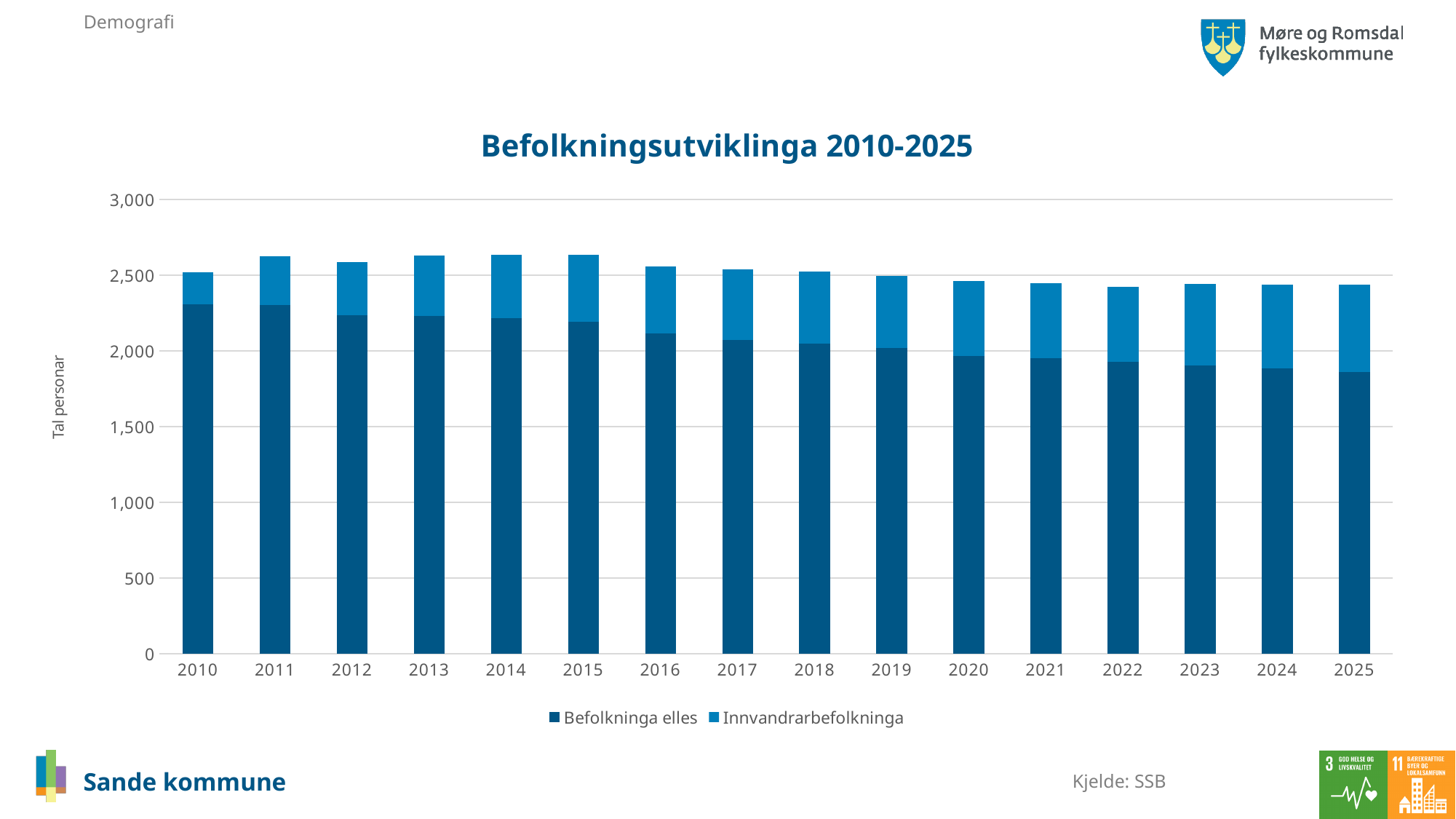
What is the label on the y axis of the chart? Tal personar Is the value of Befolkninga elles for 2025 greater or less than 2,000? less Does the Befolkninga elles series rise or fall from 2010 to 2025? fall Is the value of Befolkninga elles for 2010 greater or less than 2,000? greater Which year has the larger value for Befolkninga elles, 2010 or 2025? 2010 Which year has the taller stacked bar in total, 2013 or 2022? 2013 How many years are shown on the x axis of the chart? 16 Is the total height of the stacked bar for 2022 greater or less than 2,500? less What is the title of the chart? Befolkningsutviklinga 2010-2025 How many series does the legend list? 2 What kind of chart is shown on the slide? bar chart